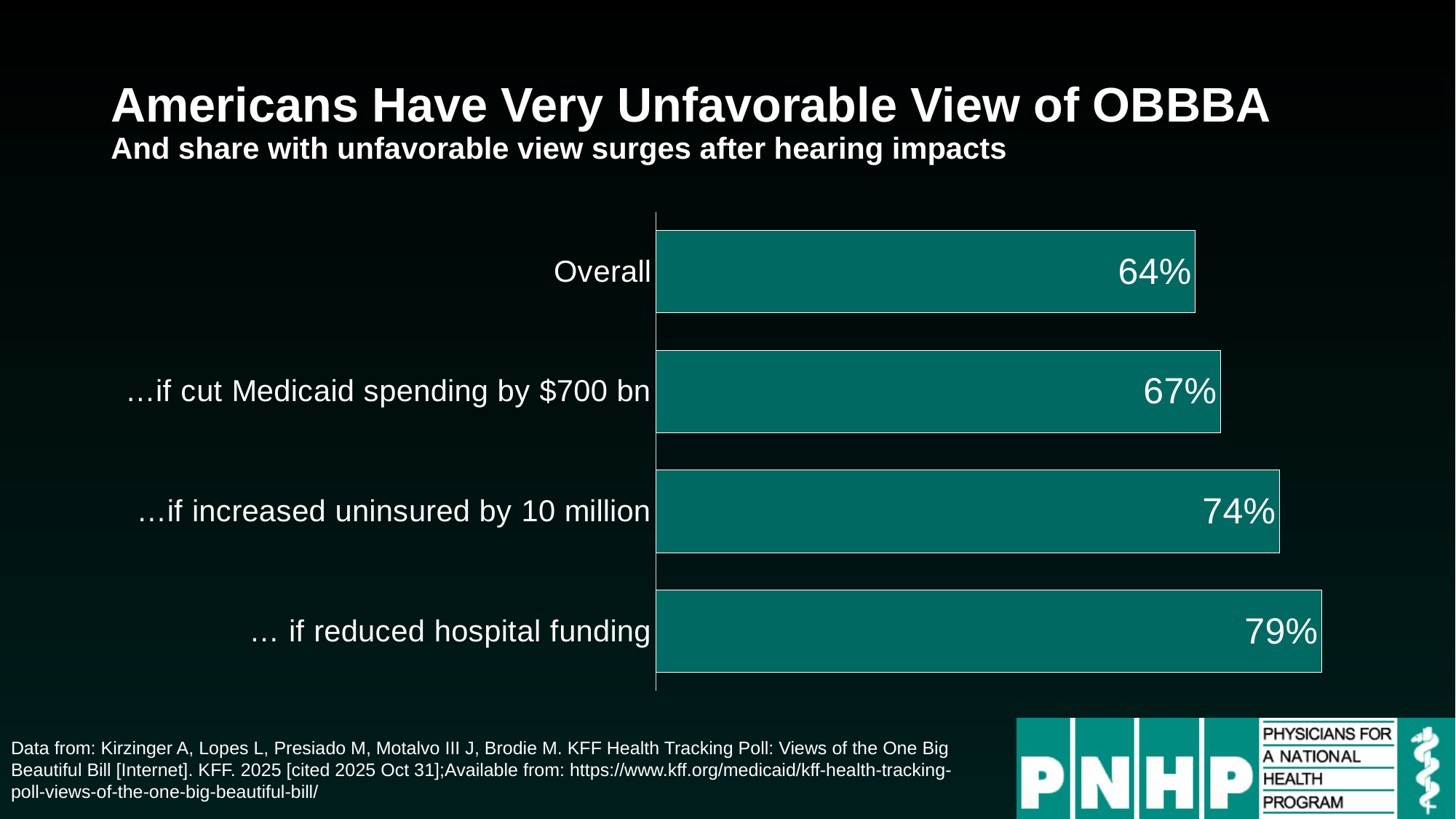
Which category has the lowest value? Overall Which is larger, the value for "…if increased uninsured by 10 million" or the value for "…if cut Medicaid spending by $700 bn"? …if increased uninsured by 10 million What is the value for "… if reduced hospital funding"? 79% Which category has the highest value? … if reduced hospital funding What is the value for "…if cut Medicaid spending by $700 bn"? 67% What is the value for "…if increased uninsured by 10 million"? 74% What kind of chart is shown on the slide? Bar chart What is the difference between the value for "…if increased uninsured by 10 million" and the value for "…if cut Medicaid spending by $700 bn"? 7% What is the title of the slide? Americans Have Very Unfavorable View of OBBBA What is the difference between the value for "… if reduced hospital funding" and the value for Overall? 15% How many categories are shown in the chart? 4 What is the value for Overall? 64%